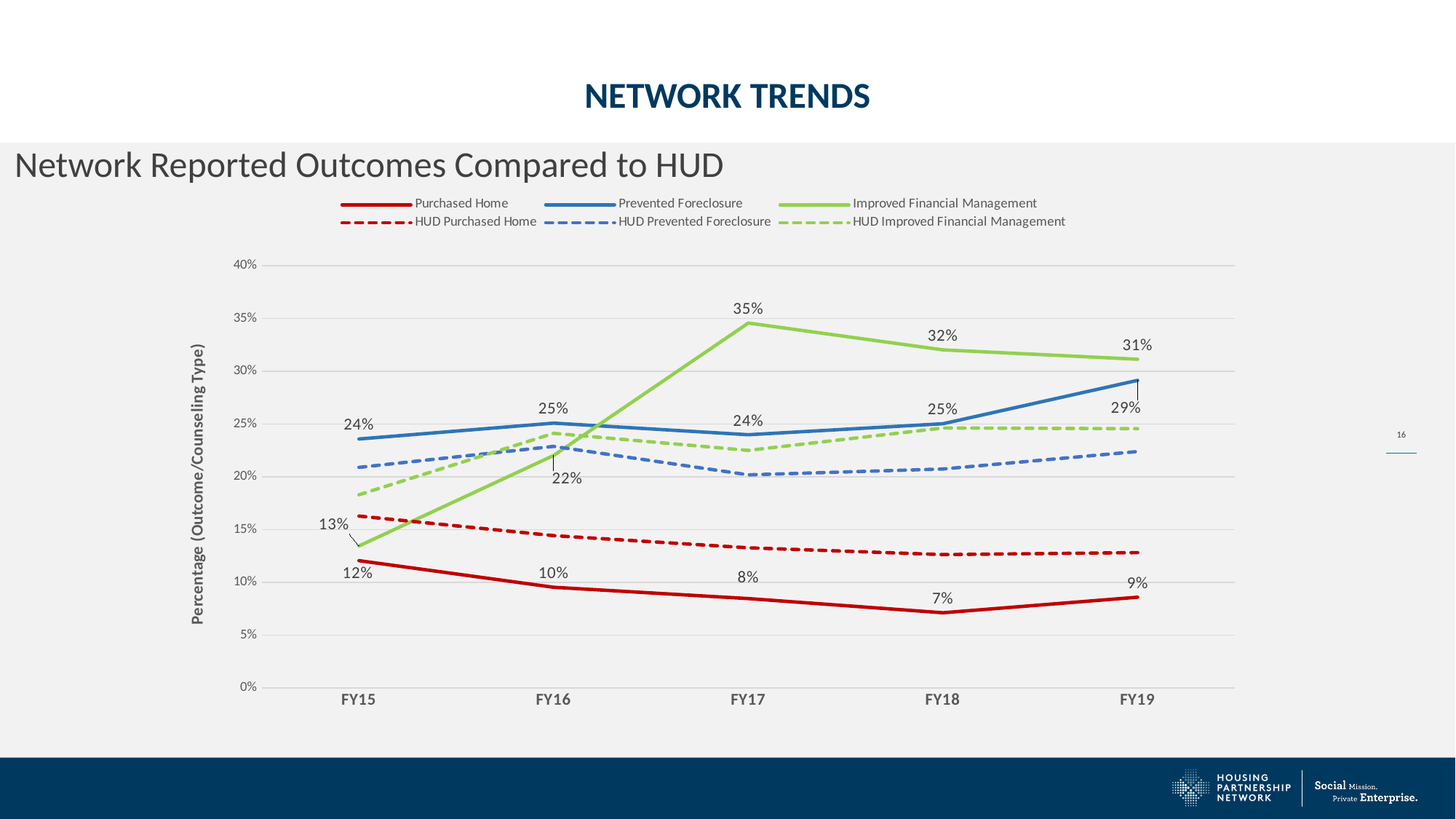
Is the value for HUD Purchased Home in FY15 greater or less than 15%? greater How many fiscal years are shown on the x axis? 5 What is the difference between Improved Financial Management in FY17 and FY15? 22% In which fiscal year is Improved Financial Management highest? FY17 In which fiscal year is Purchased Home lowest? FY18 What type of chart is shown on the slide? Line chart What is the value for Improved Financial Management in FY17? 35% What is the value for Purchased Home in FY18? 7% Which is larger in FY16: Prevented Foreclosure or Improved Financial Management? Prevented Foreclosure How many series does the legend list? 6 Does the Purchased Home line rise or fall from FY15 to FY18? Fall What is the value for Prevented Foreclosure in FY19? 29%